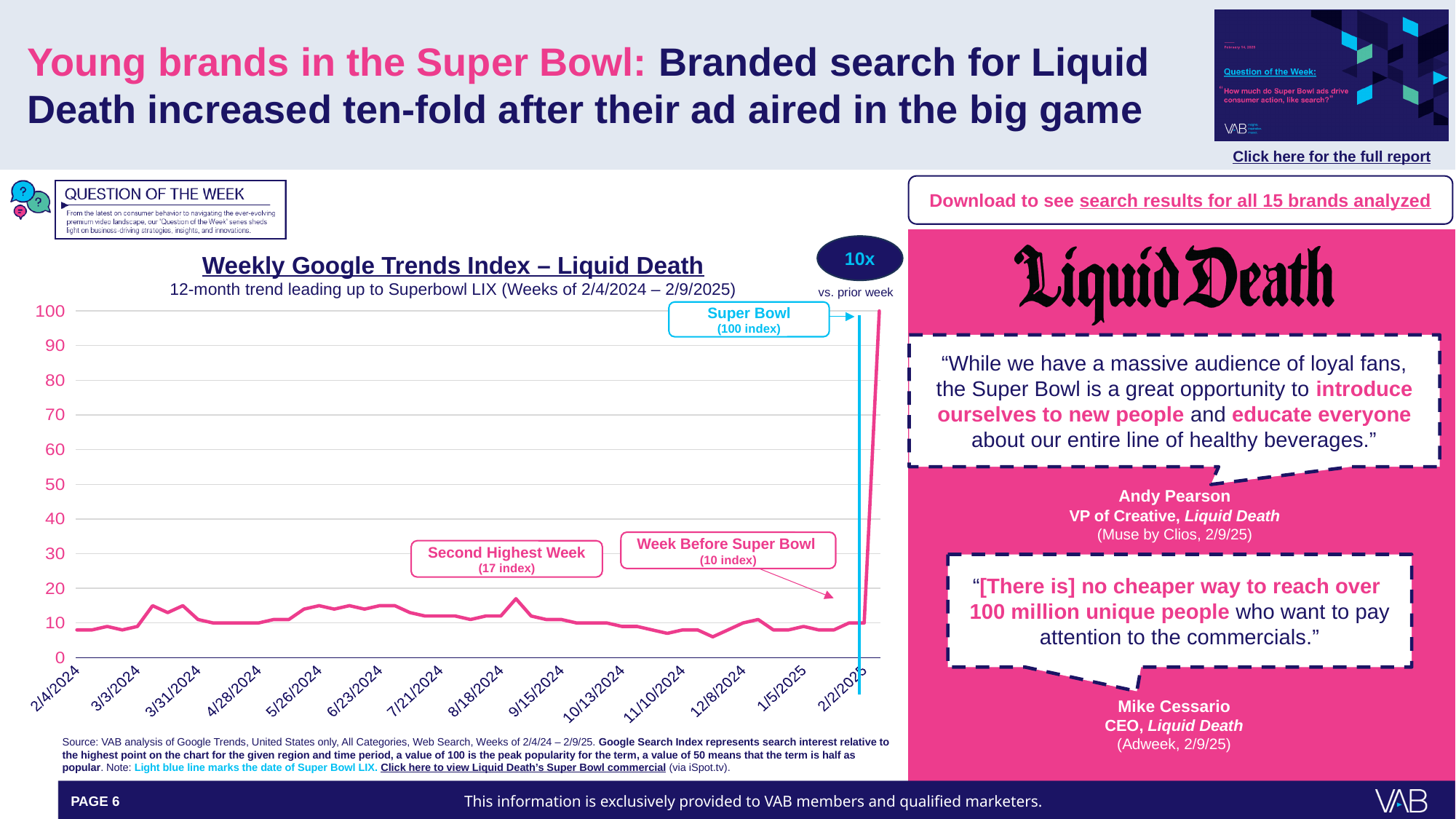
What is the difference between the Super Bowl week index and the second highest week index? 83 What is the Google Trends index value for the Super Bowl week? 100 What is the index value for the second highest week? 17 Does the index rise or fall in the final week of the chart? Rise What is the index value for the week before the Super Bowl? 10 What is the title of the chart? Weekly Google Trends Index – Liquid Death What does the light blue vertical line on the chart mark? The date of Super Bowl LIX Which is larger: the index for the second highest week or the index for the week before the Super Bowl? Second highest week By how much does the Super Bowl week index exceed the week before the Super Bowl? 90 What kind of chart is shown on the slide? Line chart Which week has the highest index value on the chart? Super Bowl week Is the index value for the week of 2/4/2024 greater or less than 20? less